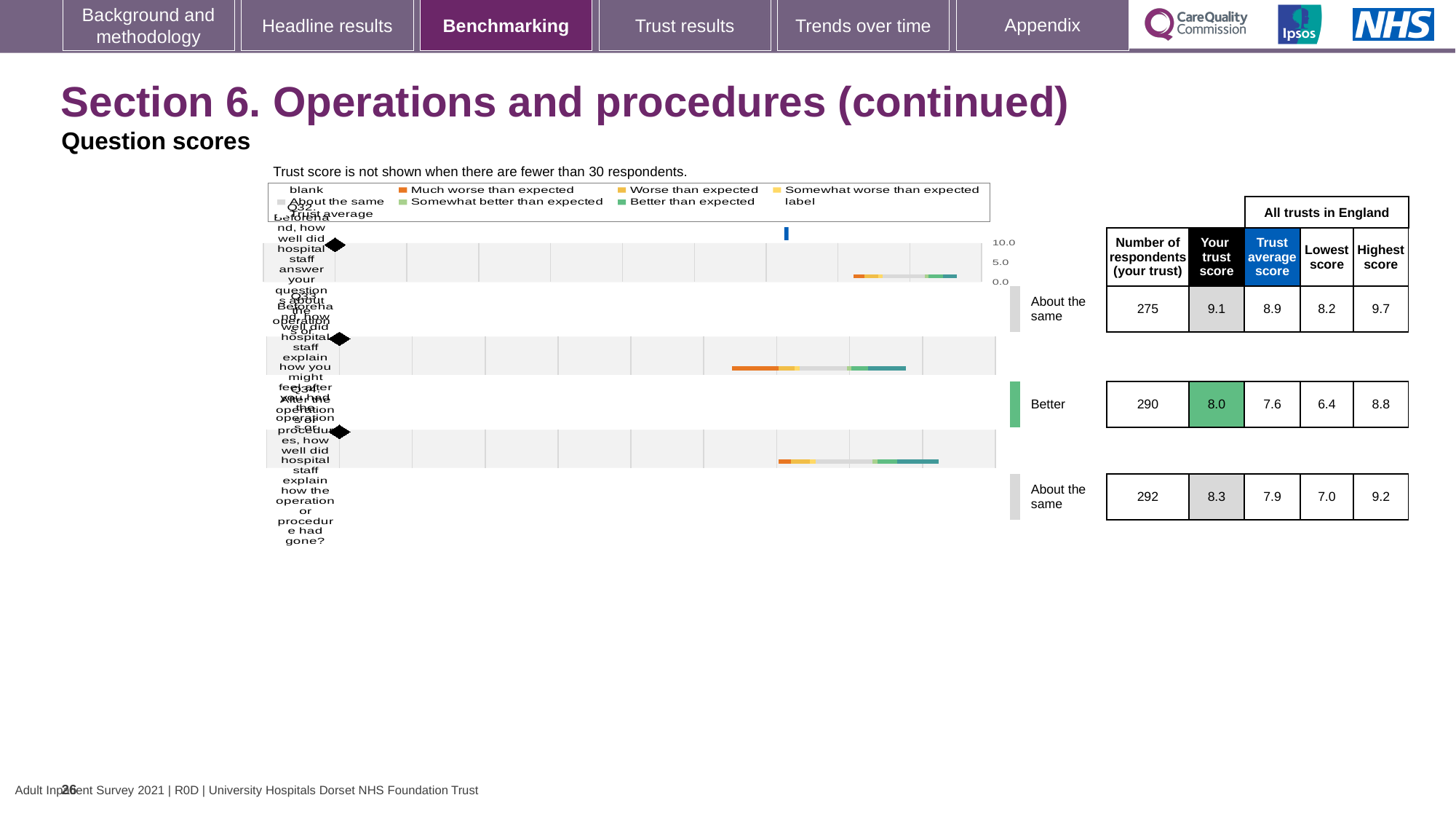
How many question rows are shown in the benchmarking chart and table? 3 In the table, what is the trust average score for the first (top) row? 8.9 What kind of chart is shown on the slide? bar chart For the first (top) row, what is the difference between "Your trust score" and the trust average score? 0.2 In the table, what is the lowest score for the row rated "Better"? 6.4 In the table, what is the lowest score for the third (bottom) row? 7.0 In the table, what is the number of respondents for the row rated "Better"? 290 In the table, what is the highest score for the first (top) row? 9.7 For the row rated "Better", which is larger: "Your trust score" or the trust average score? Your trust score In the table, what is "Your trust score" for the row rated "Better"? 8.0 Which row has the highest number of respondents? the third (bottom) row According to the note above the chart, when is the trust score not shown? when there are fewer than 30 respondents